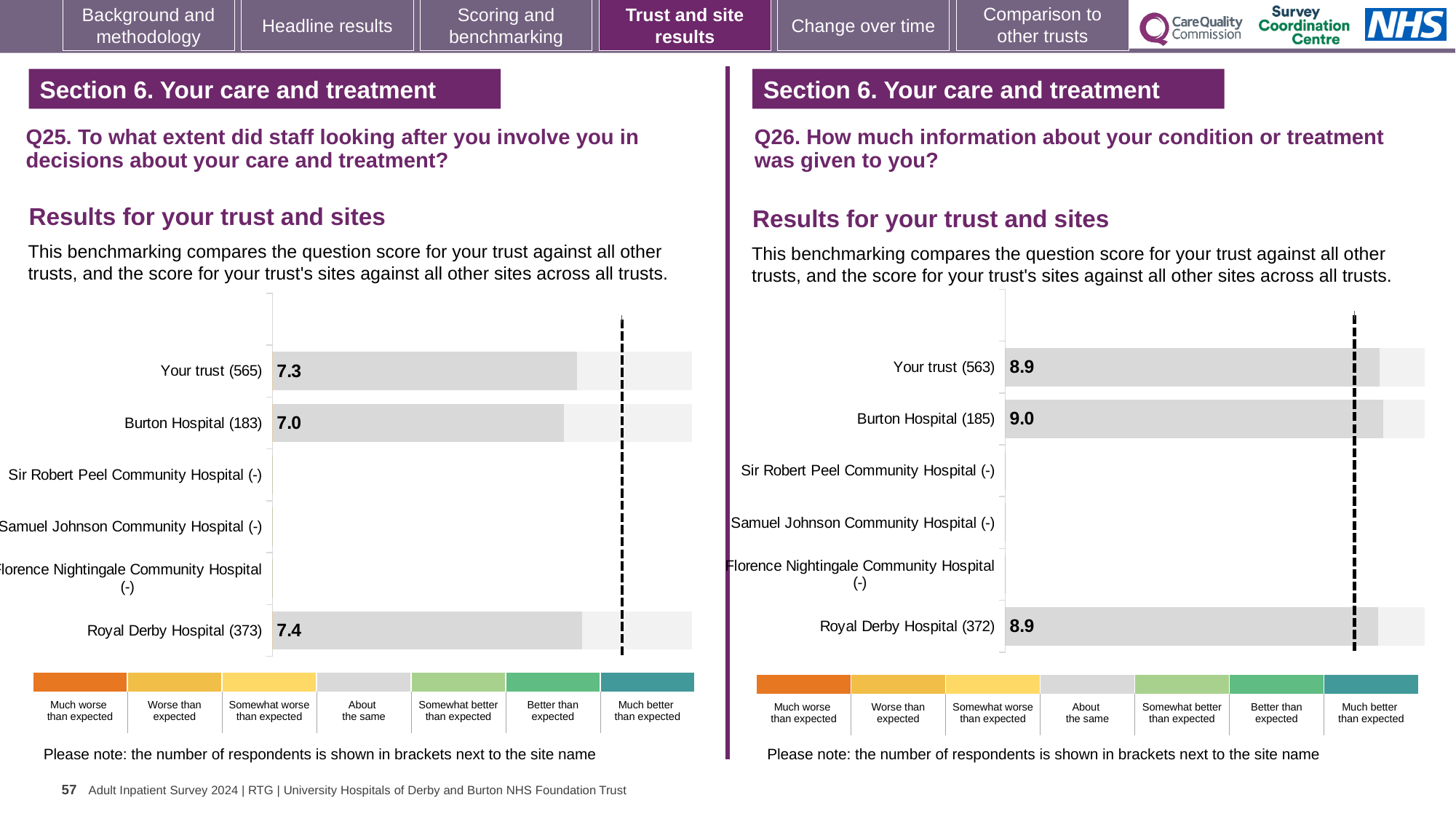
What type of chart is used in the Q26 chart on the right? Bar chart In the Q25 chart on the left, which labelled bar has the highest score? Royal Derby Hospital In the Q26 chart on the right, what is the score for Royal Derby Hospital? 8.9 How many site or trust categories are listed on the y axis of the Q25 chart on the left? 6 In the Q26 chart on the right, what is the score for Burton Hospital? 9.0 In the Q25 chart on the left, what is the difference between the Royal Derby Hospital score and the Burton Hospital score? 0.4 In the Q25 chart on the left, what is the score for Burton Hospital? 7.0 In the Q26 chart on the right, which is larger: the score for Burton Hospital or the score for Royal Derby Hospital? Burton Hospital In the Q25 chart on the left, what is the score for Royal Derby Hospital? 7.4 In the Q25 chart on the left, which site has the lowest score? Burton Hospital In the Q25 chart on the left, what is the score for Your trust? 7.3 In the Q26 chart on the right, what is the difference between the Burton Hospital score and the Your trust score? 0.1